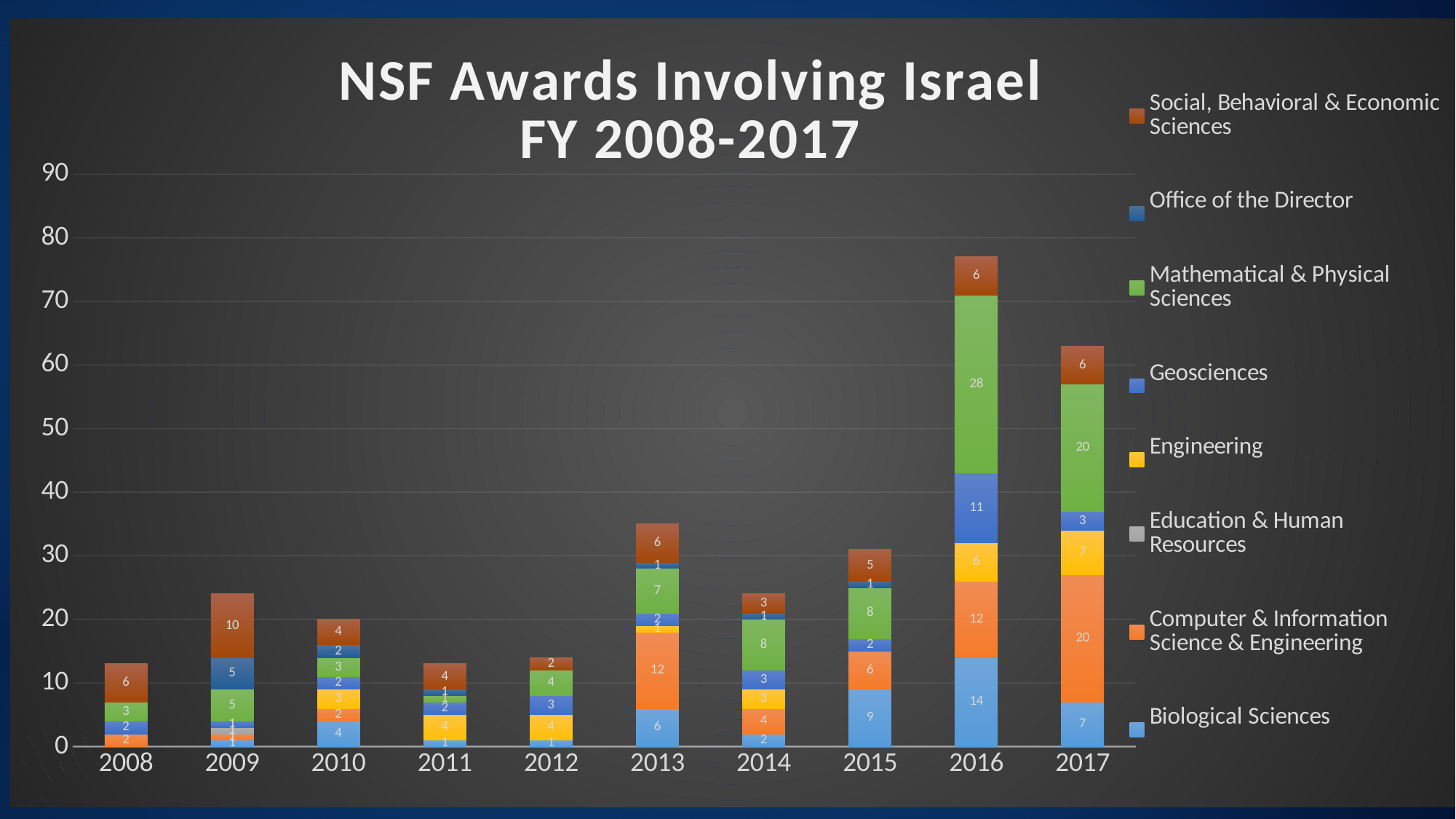
How many fiscal years are shown along the x axis? 10 What is the value for Geosciences in 2016? 11 What kind of chart is shown on the slide? Stacked bar chart What is the total of the stacked bar for 2016? 77 What is the total of the stacked bar for 2017? 63 Which year has the tallest stacked bar? 2016 Which year has the larger value for Computer & Information Science & Engineering, 2013 or 2015? 2013 What is the value for Biological Sciences in 2016? 14 What is the value for Computer & Information Science & Engineering in 2017? 20 How many series does the legend list? 8 What is the difference between the Mathematical & Physical Sciences values for 2016 and 2017? 8 What is the value for Mathematical & Physical Sciences in 2016? 28